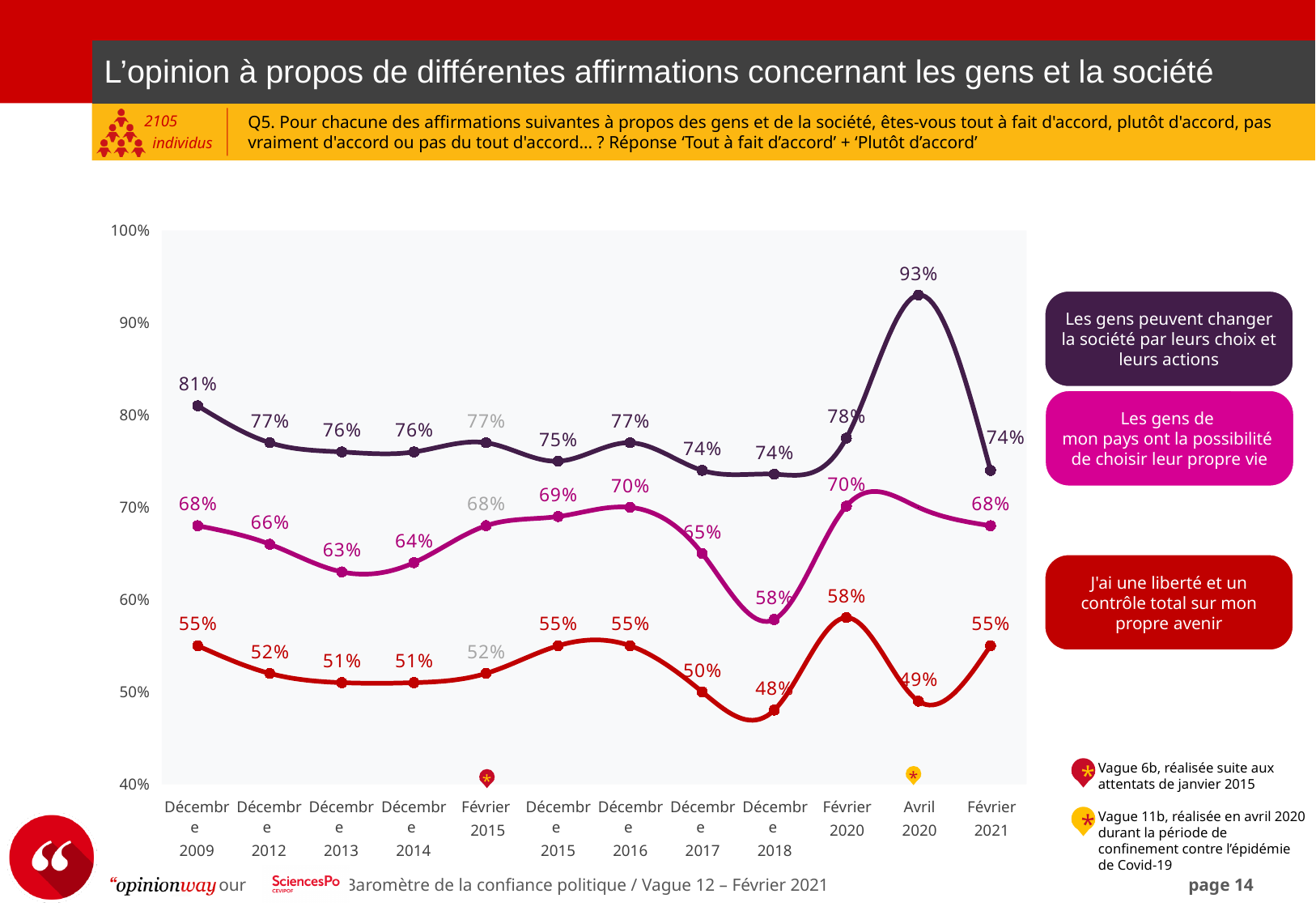
Which is larger for 'Les gens de mon pays ont la possibilité de choisir leur propre vie': Décembre 2009 or Décembre 2013? Décembre 2009 At which time point is 'Les gens peuvent changer la société par leurs choix et leurs actions' highest? Avril 2020 What type of chart is shown on the slide? line chart Is the value for 'Les gens de mon pays ont la possibilité de choisir leur propre vie' in Avril 2020 greater or less than 60%? greater What is the difference between the Avril 2020 and Février 2021 values for 'Les gens peuvent changer la société par leurs choix et leurs actions'? 19 percentage points Which series is shown in red on the chart? J'ai une liberté et un contrôle total sur mon propre avenir What is the value for 'J'ai une liberté et un contrôle total sur mon propre avenir' in Décembre 2018? 48% At which time point is 'J'ai une liberté et un contrôle total sur mon propre avenir' lowest? Décembre 2018 How many time points are plotted along the x axis? 12 How many series does the chart show? 3 What is the value for 'Les gens de mon pays ont la possibilité de choisir leur propre vie' in Février 2021? 68% What is the value for 'Les gens peuvent changer la société par leurs choix et leurs actions' in Avril 2020? 93%